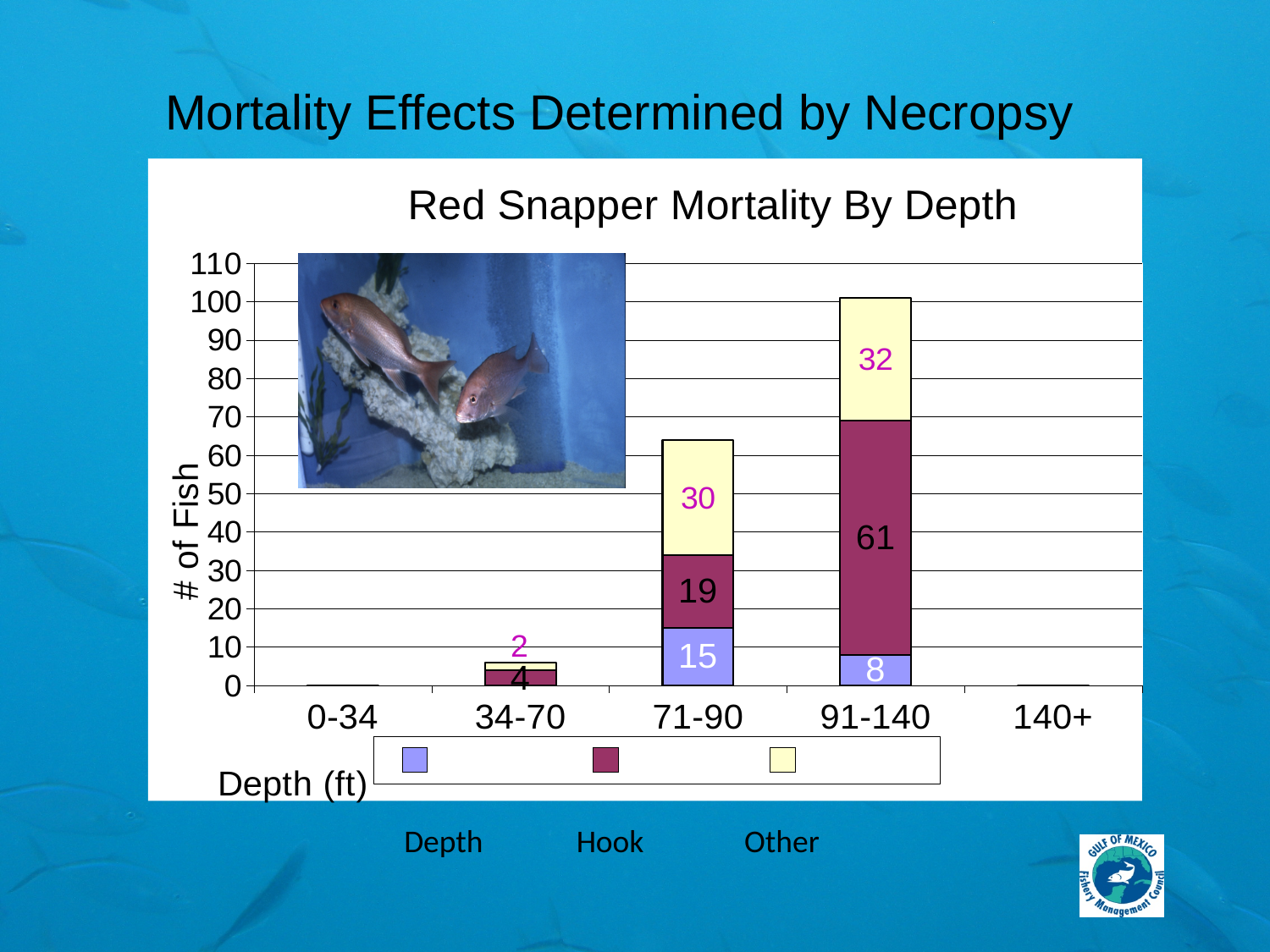
What is the Hook value for the 34-70 ft depth category? 4 Is the total height of the 91-140 bar greater or less than 100? greater What is the Depth value for the 71-90 ft depth category? 15 What type of chart is shown on the slide? stacked bar chart What is the title of the chart? Red Snapper Mortality By Depth What is the Hook value for the 91-140 ft depth category? 61 How many depth categories are shown on the x axis? 5 How many series does the legend list? 3 What is the total number of fish in the stacked bar for the 71-90 ft depth category? 64 What is the difference between the Hook values for the 91-140 and 71-90 depth categories? 42 Which depth category has the tallest stacked bar? 91-140 What is the Other value for the 71-90 ft depth category? 30